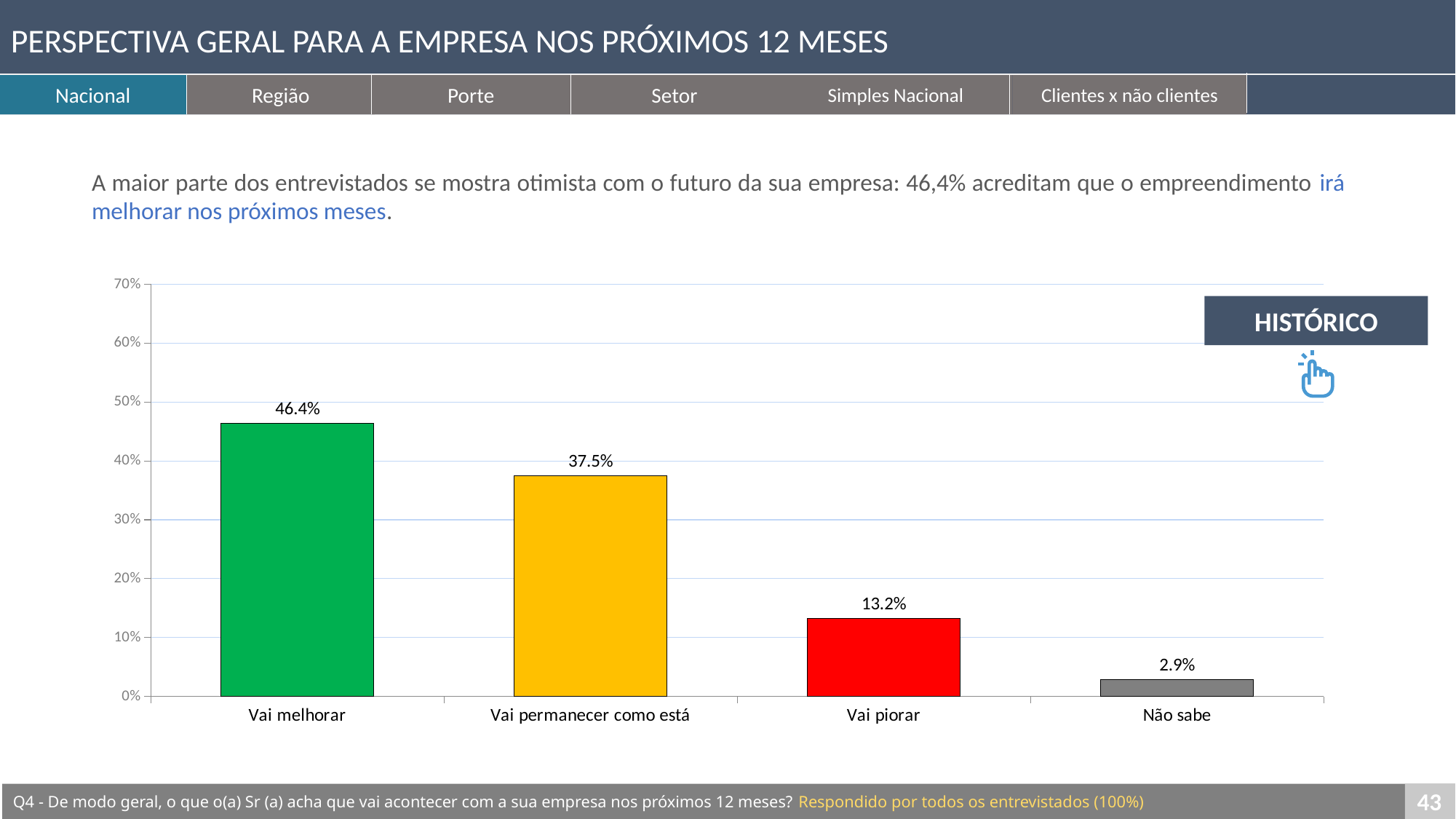
How many categories are shown on the x axis of the chart? 4 What is the difference between the values for "Vai melhorar" and "Vai permanecer como está"? 8.9% What is the value for "Vai piorar"? 13.2% What is the value for "Vai melhorar"? 46.4% Which category has the highest value? Vai melhorar What is the value for "Não sabe"? 2.9% Is the value for "Vai permanecer como está" greater or less than 40%? less Which is larger, the value for "Vai piorar" or the value for "Não sabe"? Vai piorar What kind of chart is shown on the slide? bar chart What colour is the bar for "Vai piorar"? red What is the value for "Vai permanecer como está"? 37.5% Which category has the lowest value? Não sabe